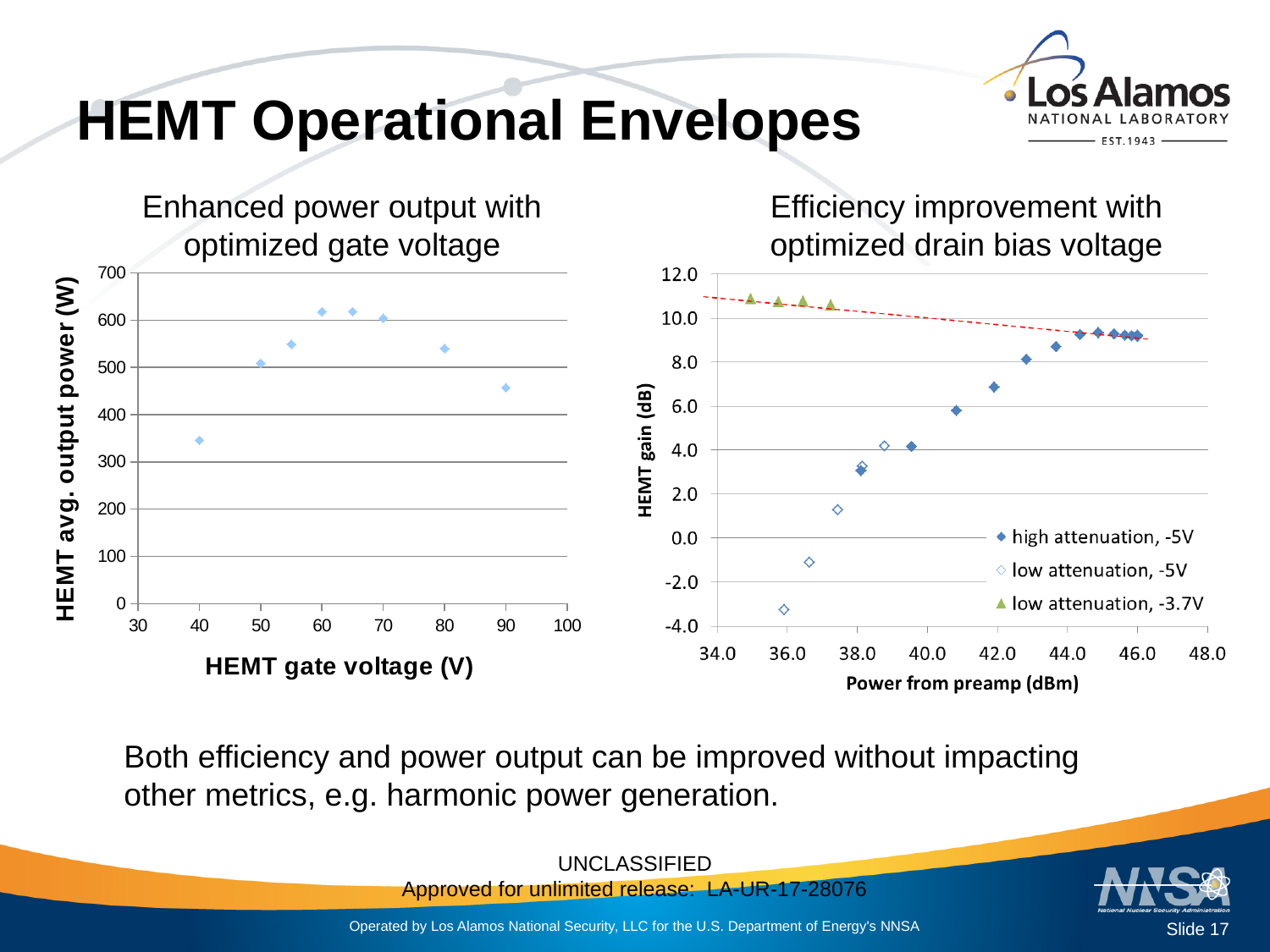
How many series does the legend of the right chart, 'Efficiency improvement with optimized drain bias voltage', list? 3 On the left chart, 'Enhanced power output with optimized gate voltage', is the output power at a gate voltage of 40 V greater or less than 400 W? less On the left chart, 'Enhanced power output with optimized gate voltage', is the output power at 50 V larger or smaller than at 90 V? larger On the right chart, 'Efficiency improvement with optimized drain bias voltage', is the lowest 'low attenuation, -5V' gain value greater or less than -2.0 dB? less On the left chart, 'Enhanced power output with optimized gate voltage', is the output power at a gate voltage of 60 V greater or less than 600 W? greater On the left chart, 'Enhanced power output with optimized gate voltage', which gate voltage has the lowest average output power? 40 V What is the x-axis title of the left chart, 'Enhanced power output with optimized gate voltage'? HEMT gate voltage (V) On the left chart, 'Enhanced power output with optimized gate voltage', does the output power rise or fall as gate voltage increases from 40 V to 60 V? rise How many data points are plotted on the left chart, 'Enhanced power output with optimized gate voltage'? 8 On the right chart, 'Efficiency improvement with optimized drain bias voltage', does the 'high attenuation, -5V' gain rise or fall as power from preamp increases from 40.0 to 44.0 dBm? rise What kind of chart is the left chart, 'Enhanced power output with optimized gate voltage'? scatter chart